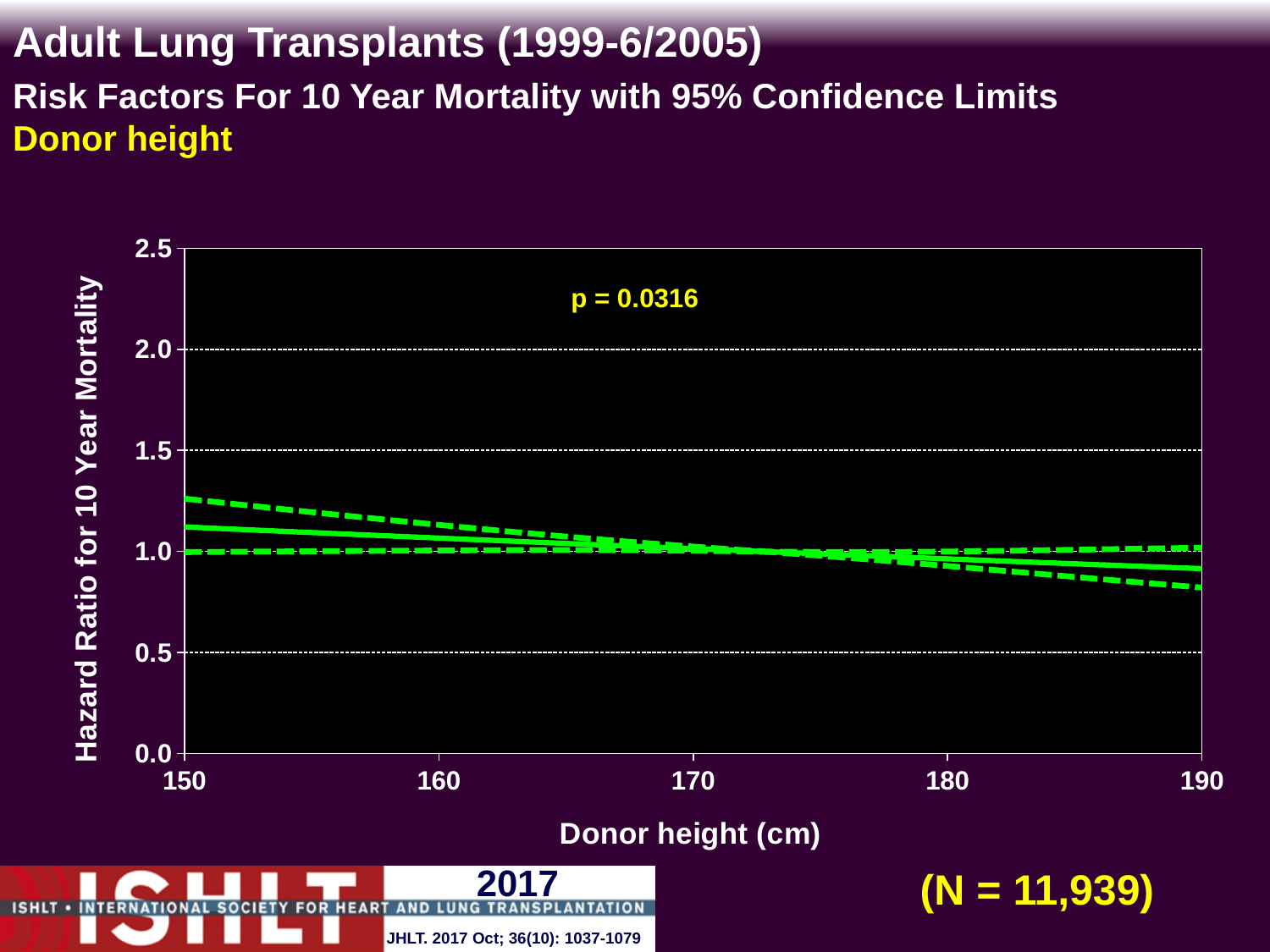
What is the label of the x axis? Donor height (cm) What kind of chart is shown on the slide? line chart What is the label of the y axis? Hazard Ratio for 10 Year Mortality At a donor height of 190 cm, is the hazard ratio on the solid line greater or less than 1.5? less Is the hazard ratio on the solid line higher at 150 cm or at 190 cm donor height? 150 cm What is the p-value printed on the chart? p = 0.0316 At a donor height of 150 cm, is the hazard ratio on the solid line greater or less than 1.0? greater At a donor height of 150 cm, is the upper confidence limit (upper dashed line) greater or less than 1.5? less What sample size (N) is shown on the slide? N = 11,939 How many lines are plotted on the chart? 3 Does the hazard ratio (solid line) rise or fall as donor height increases from 150 cm to 190 cm? fall